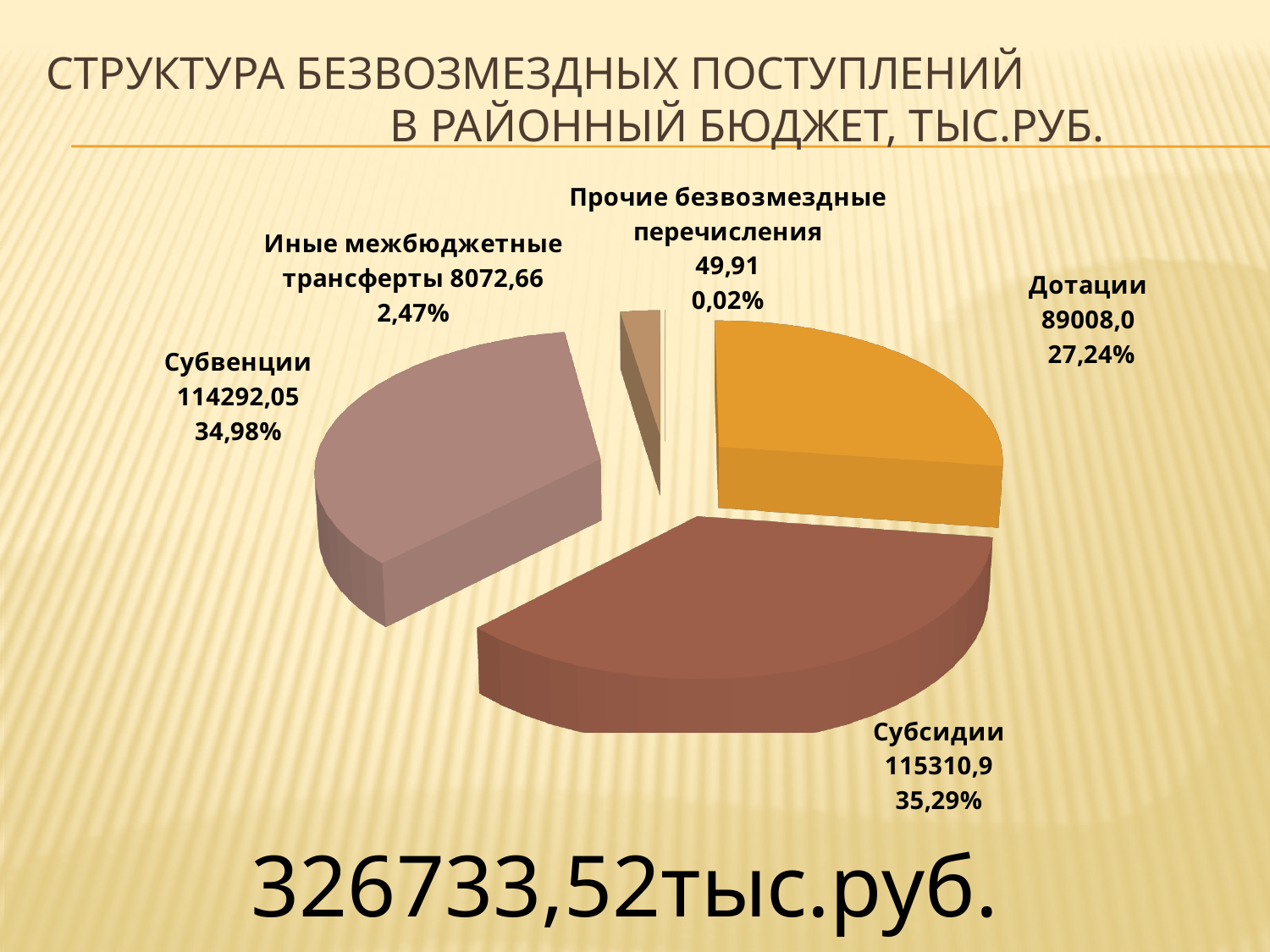
What is the value for Прочие безвозмездные перечисления? 49,91 What is the value for Иные межбюджетные трансферты? 8072,66 Which category has the largest value? Субсидии What is the value for Дотации? 89008,0 What share of the pie does Дотации represent? 27,24% Which is larger, the value for Субвенции or the value for Дотации? Субвенции What is the value for Субвенции? 114292,05 What is the difference between the values for Субсидии and Дотации? 26302,9 What kind of chart is shown on the slide? pie chart What share of the pie does Субсидии represent? 35,29% How many slices does the pie chart have? 5 Which category has the smallest value? Прочие безвозмездные перечисления